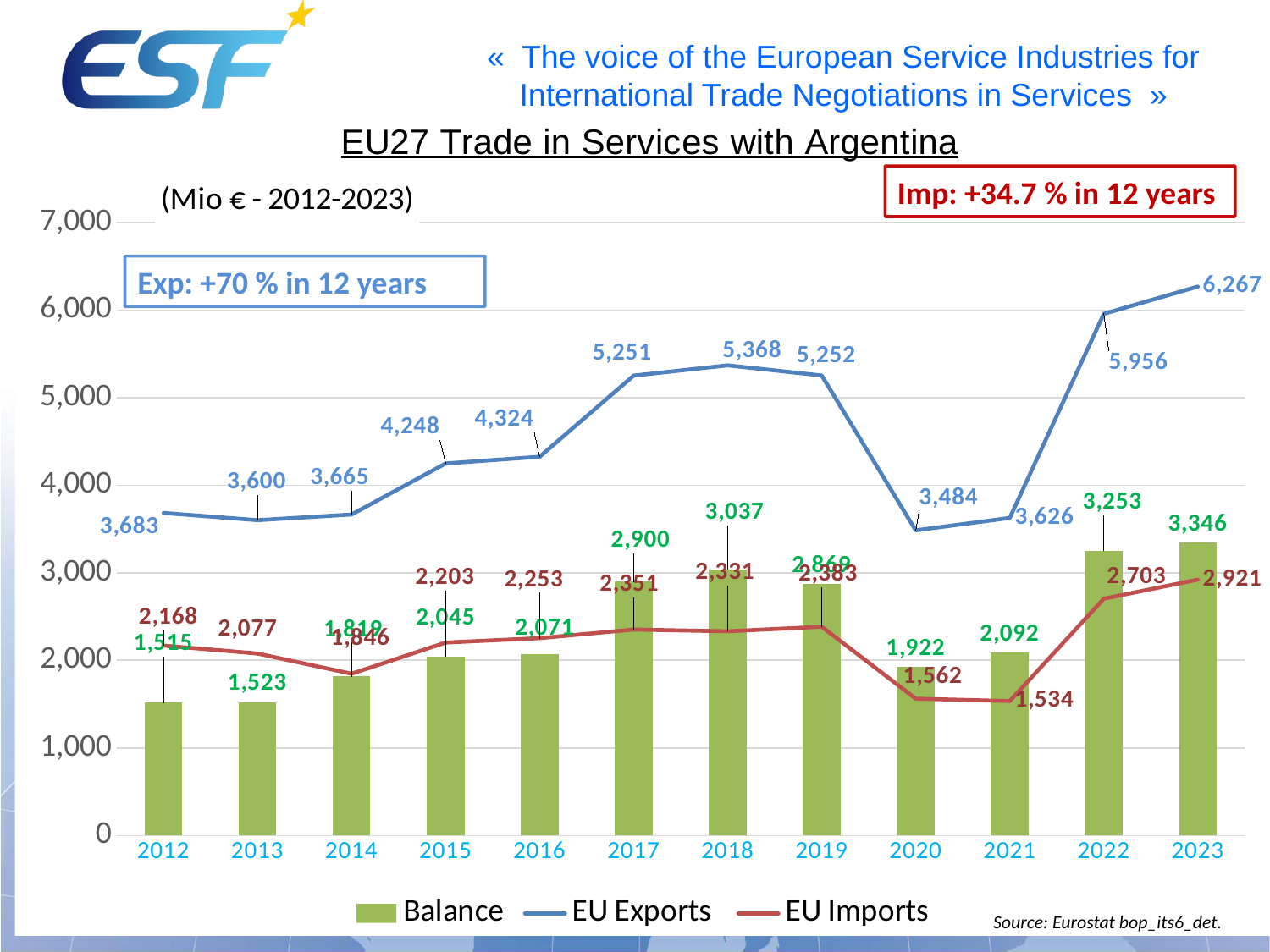
What is the Balance value for 2022? 3,253 Which year has the larger Balance, 2018 or 2019? 2018 How many series does the legend list? 3 What kind of chart is this? Combined bar and line chart In which year are EU Exports highest? 2023 Did EU Exports rise or fall from 2019 to 2020? Fall By how much did EU Exports increase from 2022 to 2023? 311 According to the annotation box, by what percentage did exports grow in 12 years? +70 % How many years are shown on the x axis? 12 In which year are EU Imports lowest? 2021 What is the value of EU Imports in 2020? 1,562 What is the value of EU Exports in 2023? 6,267